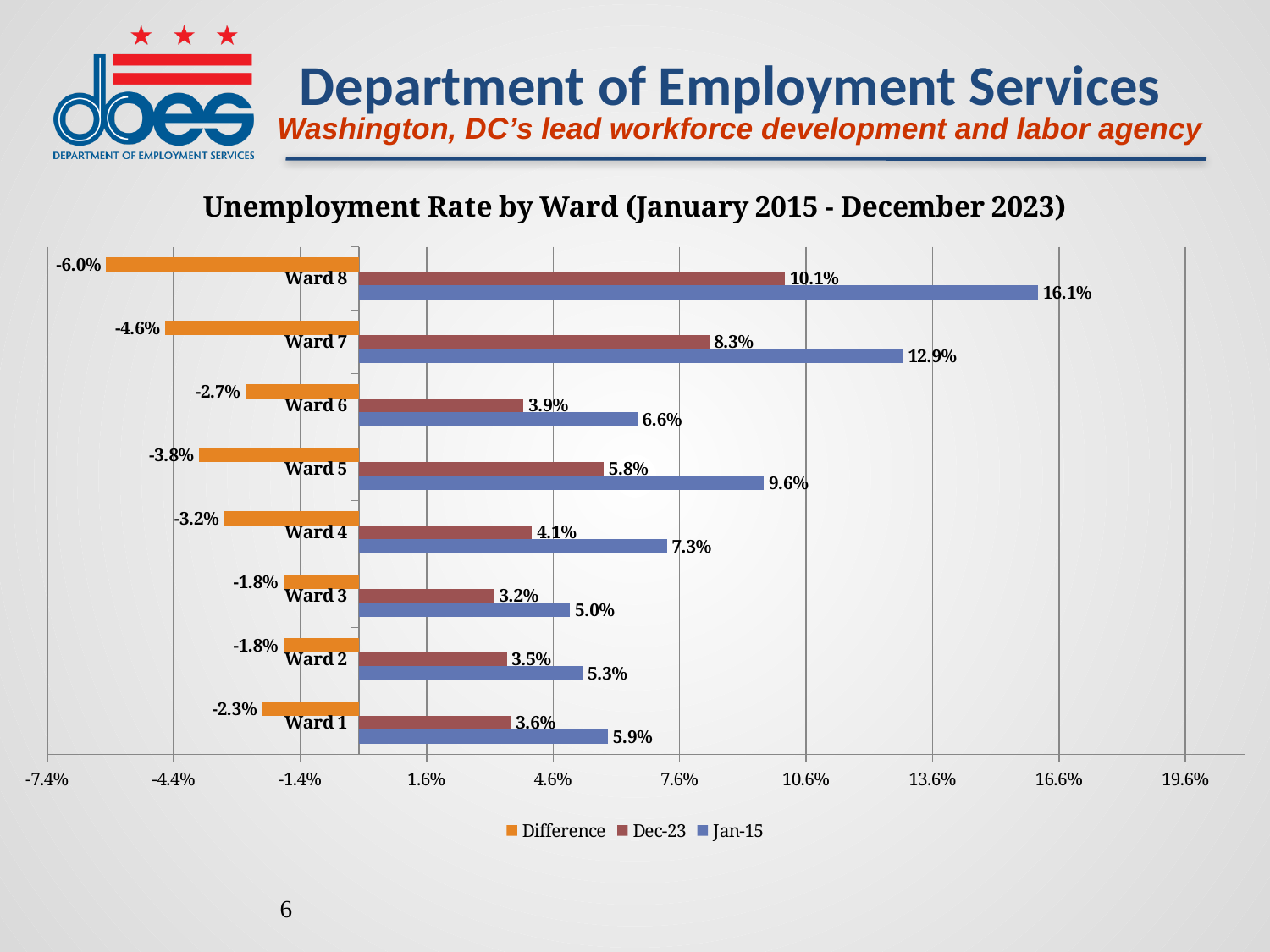
Is the Jan-15 value for Ward 7 greater or less than 10.6%? greater What is the title of the chart? Unemployment Rate by Ward (January 2015 - December 2023) What is the Jan-15 unemployment rate for Ward 8? 16.1% Which ward has the highest Jan-15 unemployment rate? Ward 8 What kind of chart is shown on the slide? Bar chart How many wards are shown on the chart? 8 Which ward has the lowest Dec-23 unemployment rate? Ward 3 What is the difference between the Jan-15 and Dec-23 unemployment rates for Ward 5? 3.8% What is the Difference value shown for Ward 7? -4.6% What is the Dec-23 unemployment rate for Ward 4? 4.1% Which is larger, the Dec-23 rate for Ward 2 or the Dec-23 rate for Ward 1? Ward 1 How many series does the legend list? 3